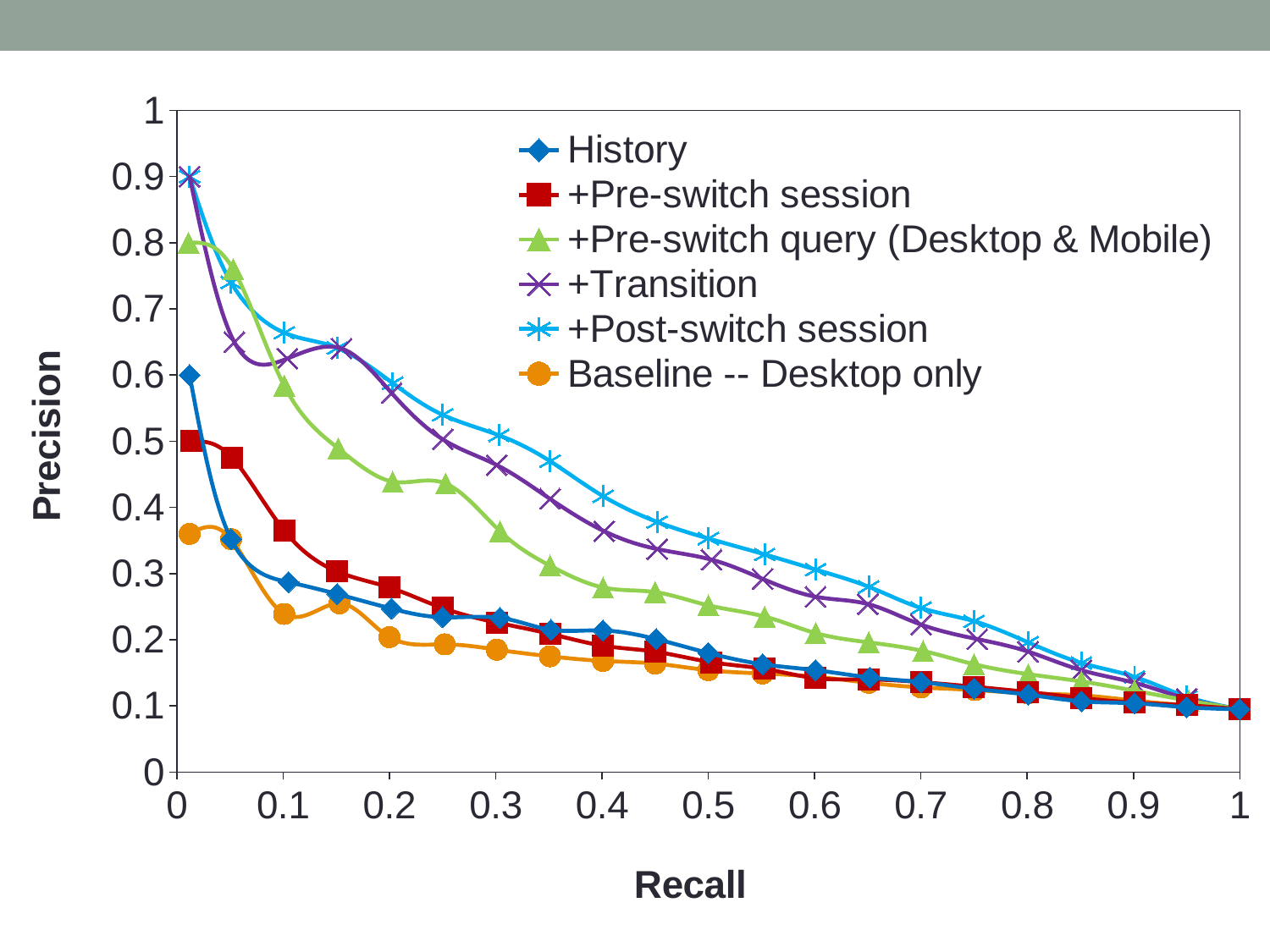
Is the precision of +Transition at recall 0.2 greater or less than 0.5? greater Which series has the lowest precision at recall 0.2? Baseline -- Desktop only Is the precision of +Pre-switch query (Desktop & Mobile) at recall 0.3 greater or less than 0.3? greater How many series does the legend list? 6 Is the precision of Baseline -- Desktop only at recall 0.1 greater or less than 0.3? less Which series has the highest precision at recall 0.5? +Post-switch session As recall increases along the x axis, does precision for the +Post-switch session series rise or fall? fall What is the label of the vertical axis? Precision At recall 0.4, which has higher precision: +Post-switch session or +Pre-switch query (Desktop & Mobile)? +Post-switch session What is the label of the horizontal axis? Recall What kind of chart is shown on the slide? line chart